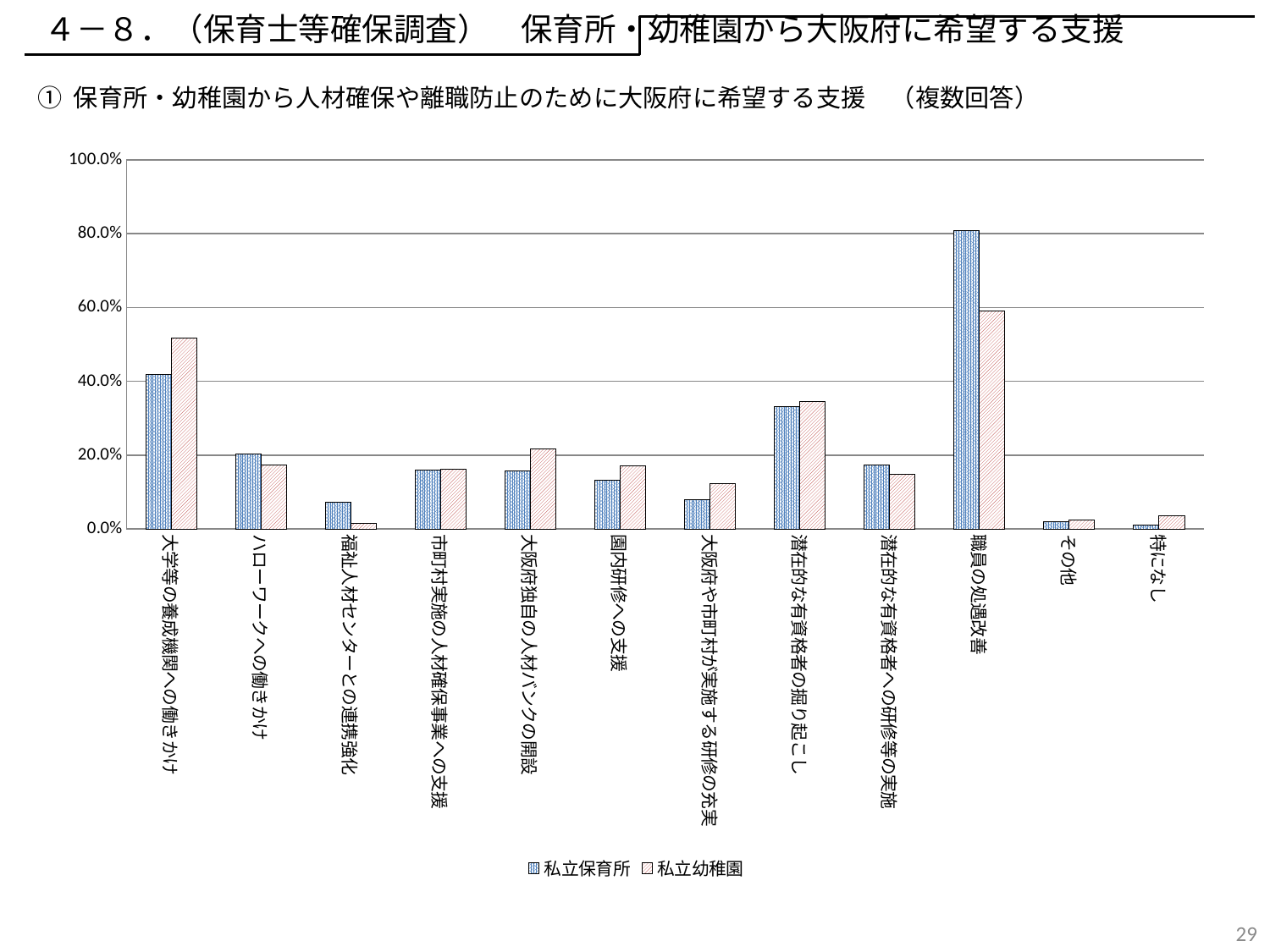
Which category has the highest value for 私立幼稚園? 職員の処遇改善 How many categories are shown on the x axis of the chart? 12 What kind of chart is shown on the slide? bar chart For 大阪府独自の人材バンクの開設, which series has the larger value, 私立保育所 or 私立幼稚園? 私立幼稚園 For 職員の処遇改善, which series has the larger value, 私立保育所 or 私立幼稚園? 私立保育所 Is the value for 私立保育所 in 職員の処遇改善 greater or less than 60.0%? greater Which category has the highest value for 私立保育所? 職員の処遇改善 What are the two series names listed in the legend? 私立保育所 and 私立幼稚園 How many series does the legend list? 2 For 大学等の養成機関への働きかけ, which series has the larger value, 私立保育所 or 私立幼稚園? 私立幼稚園 Is the value for 私立保育所 in 福祉人材センターとの連携強化 greater or less than 20.0%? less Is the value for 私立幼稚園 in 大学等の養成機関への働きかけ greater or less than 40.0%? greater